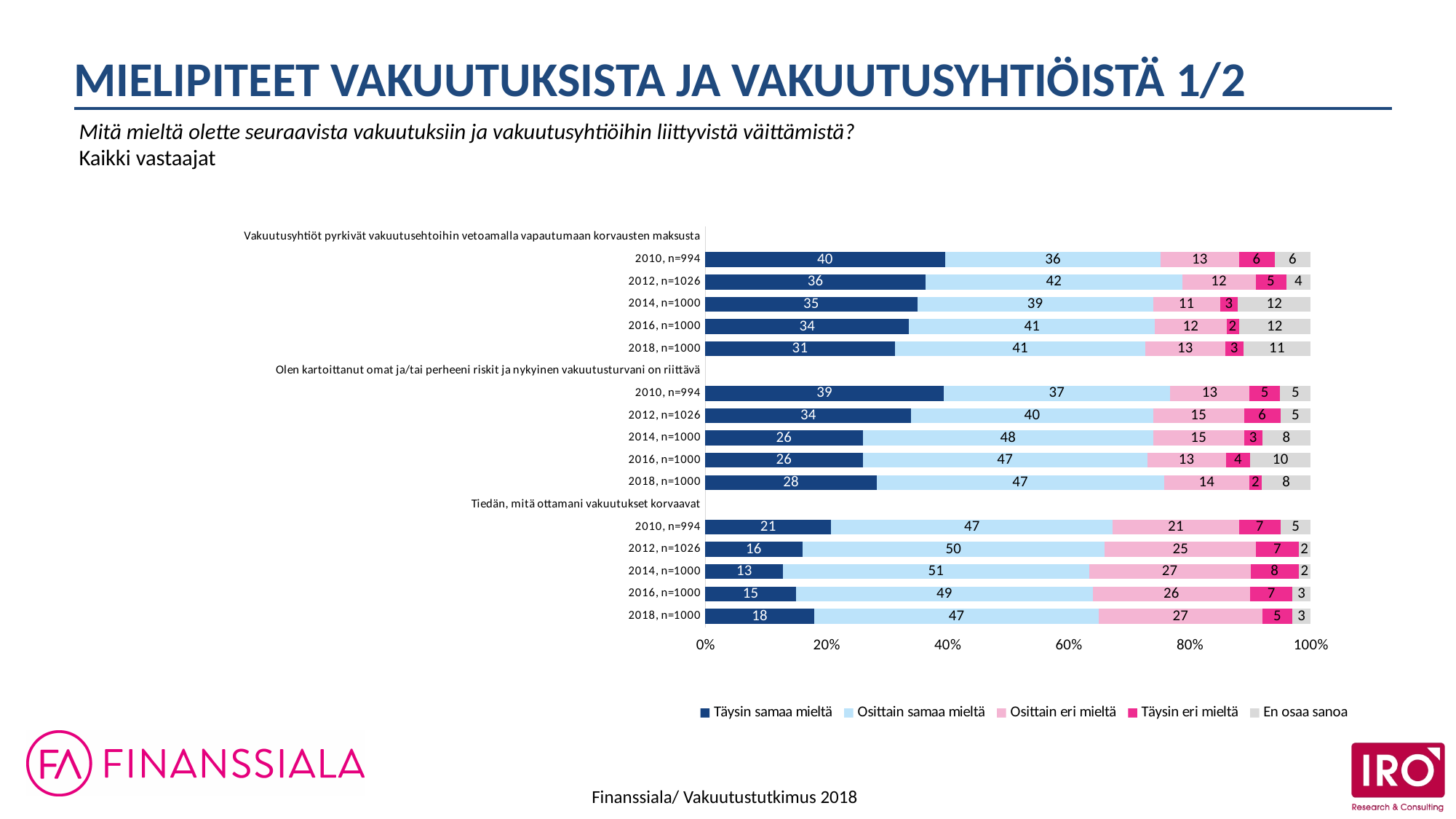
What kind of chart is shown on the slide? Stacked bar chart How many series does the legend list? 5 Which legend entry is shown in the darkest blue colour? Täysin samaa mieltä How many year rows (bars) are plotted in the chart in total? 15 Under 'Vakuutusyhtiöt pyrkivät vakuutusehtoihin vetoamalla vapautumaan korvausten maksusta', which year has the lowest 'Täysin samaa mieltä' value? 2018, n=1000 Under 'Vakuutusyhtiöt pyrkivät vakuutusehtoihin vetoamalla vapautumaan korvausten maksusta', does the 'Täysin samaa mieltä' value rise or fall from 2010 to 2018? Fall What is the 'Täysin samaa mieltä' value for 2018, n=1000 under 'Tiedän, mitä ottamani vakuutukset korvaavat'? 18 What is the 'En osaa sanoa' value for 2016, n=1000 under 'Vakuutusyhtiöt pyrkivät vakuutusehtoihin vetoamalla vapautumaan korvausten maksusta'? 12 What is the 'Osittain samaa mieltä' value for 2014, n=1000 under 'Olen kartoittanut omat ja/tai perheeni riskit ja nykyinen vakuutusturvani on riittävä'? 48 Under 'Tiedän, mitä ottamani vakuutukset korvaavat', which year has the highest 'Täysin samaa mieltä' value? 2010, n=994 Under 'Vakuutusyhtiöt pyrkivät vakuutusehtoihin vetoamalla vapautumaan korvausten maksusta', what is the difference between the 'Täysin samaa mieltä' values for 2010, n=994 and 2018, n=1000? 9 Under 'Olen kartoittanut omat ja/tai perheeni riskit ja nykyinen vakuutusturvani on riittävä', which is larger: the 'Täysin samaa mieltä' value for 2010, n=994 or for 2018, n=1000? 2010, n=994